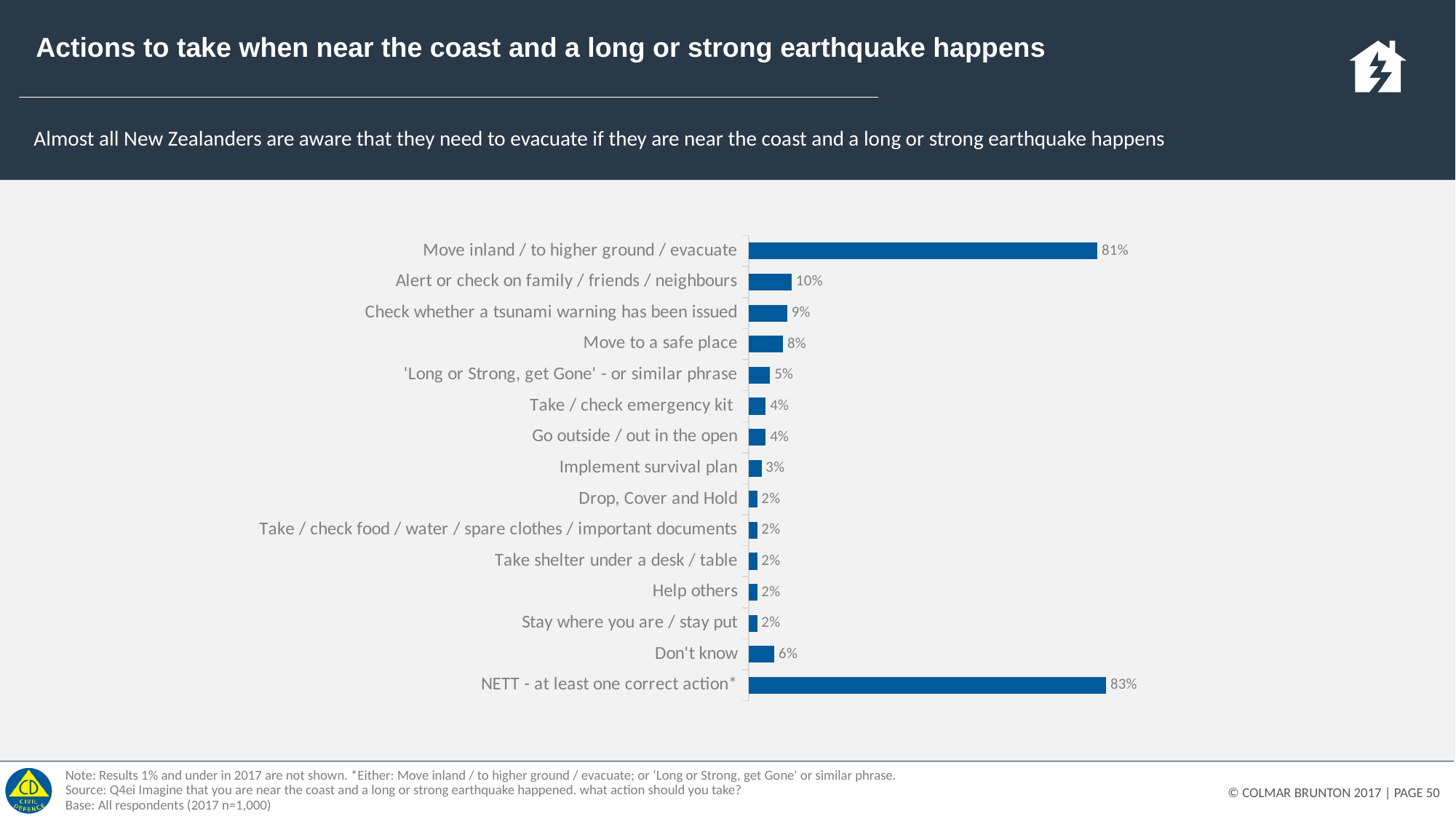
What percentage said they would check whether a tsunami warning has been issued? 9% What is the title of the slide? Actions to take when near the coast and a long or strong earthquake happens What is the value for 'NETT - at least one correct action*'? 83% What is the value for ''Long or Strong, get Gone' - or similar phrase'? 5% Which category has the highest value on the chart? NETT - at least one correct action* How many categories are shown on the chart? 15 What kind of chart is shown on the slide? Bar chart Which is larger: 'Move to a safe place' or 'Take / check emergency kit'? Move to a safe place What percentage of respondents said they would move inland / to higher ground / evacuate? 81% What is the value for 'Don't know'? 6% What is the difference between 'Move inland / to higher ground / evacuate' and 'Alert or check on family / friends / neighbours'? 71% What is the difference between 'NETT - at least one correct action*' and 'Move inland / to higher ground / evacuate'? 2%